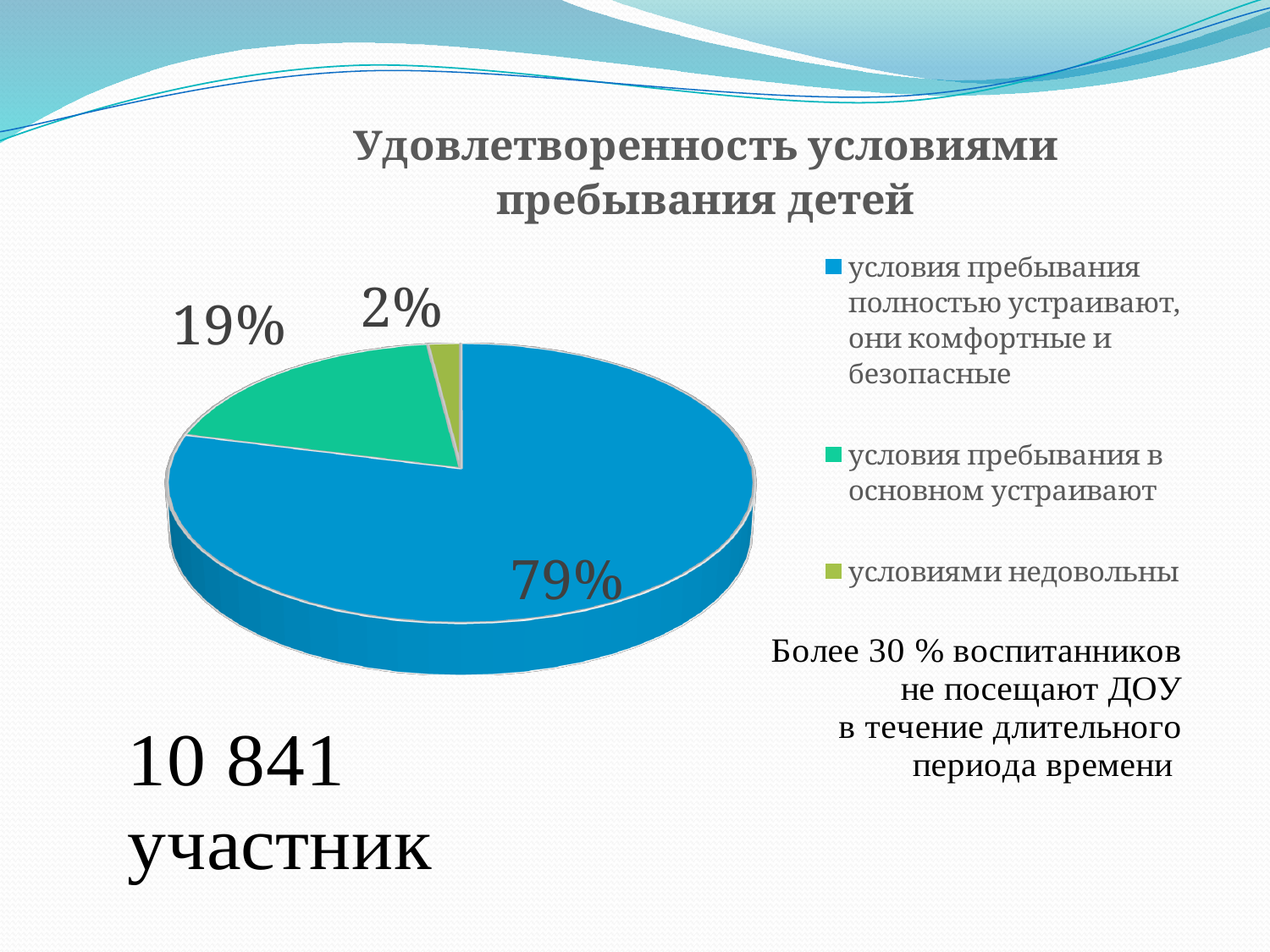
Which category has the smallest slice of the pie? условиями недовольны What share of the pie is labelled "условия пребывания в основном устраивают"? 19% What share of the pie is labelled "условия пребывания полностью устраивают, они комфортные и безопасные"? 79% What is the title of the chart? Удовлетворенность условиями пребывания детей What share of the pie is labelled "условиями недовольны"? 2% What colour is the slice for "условиями недовольны"? green (yellow-green) What is the difference in percentage points between the "условия пребывания полностью устраивают" slice and the "условия пребывания в основном устраивают" slice? 60 What kind of chart is shown on the slide? pie chart How many entries does the legend list? 3 How many slices does the pie chart have? 3 Which category has the largest slice of the pie? условия пребывания полностью устраивают, они комфортные и безопасные Which is larger: the "условия пребывания в основном устраивают" slice or the "условиями недовольны" slice? условия пребывания в основном устраивают